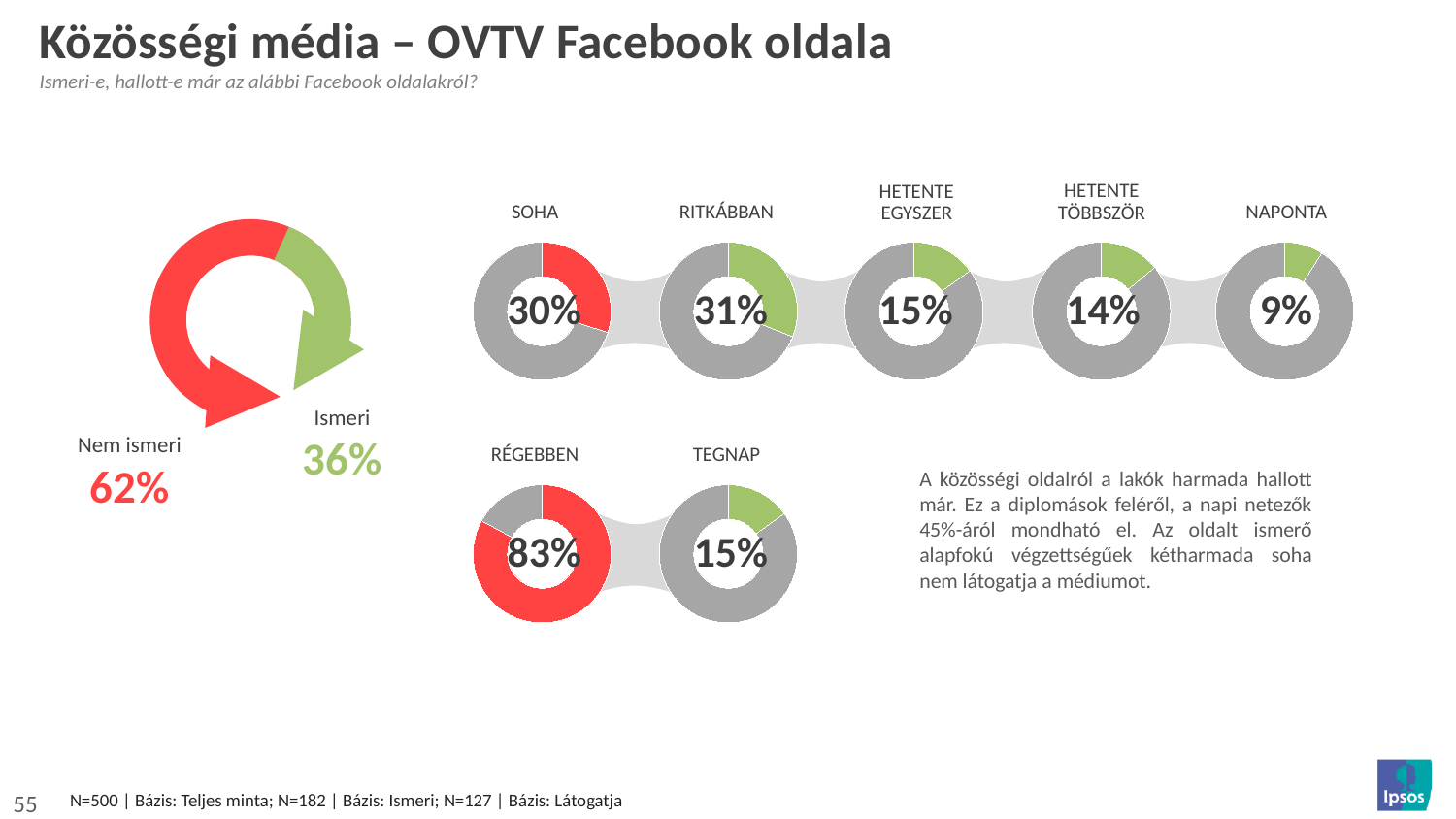
In the row of five donut charts at the top, which category has the lowest value? NAPONTA In the large donut chart on the left, which is larger, "Nem ismeri" or "Ismeri"? Nem ismeri In the row of five donut charts at the top, what is the value shown for "SOHA"? 30% In the pair of donut charts at the bottom, what is the value shown for "TEGNAP"? 15% In the pair of donut charts at the bottom, what is the value shown for "RÉGEBBEN"? 83% In the row of five donut charts at the top, what is the difference between "HETENTE EGYSZER" and "HETENTE TÖBBSZÖR"? 1% In the large donut chart on the left, what is the difference between "Nem ismeri" and "Ismeri"? 26% In the large donut chart on the left, what is the value for "Ismeri"? 36% In the row of five donut charts at the top, which category has the highest value? RITKÁBBAN In the large donut chart on the left, what is the value for "Nem ismeri"? 62% How many donut charts are in the top row (SOHA to NAPONTA)? 5 In the row of five donut charts at the top, what is the value shown for "NAPONTA"? 9%